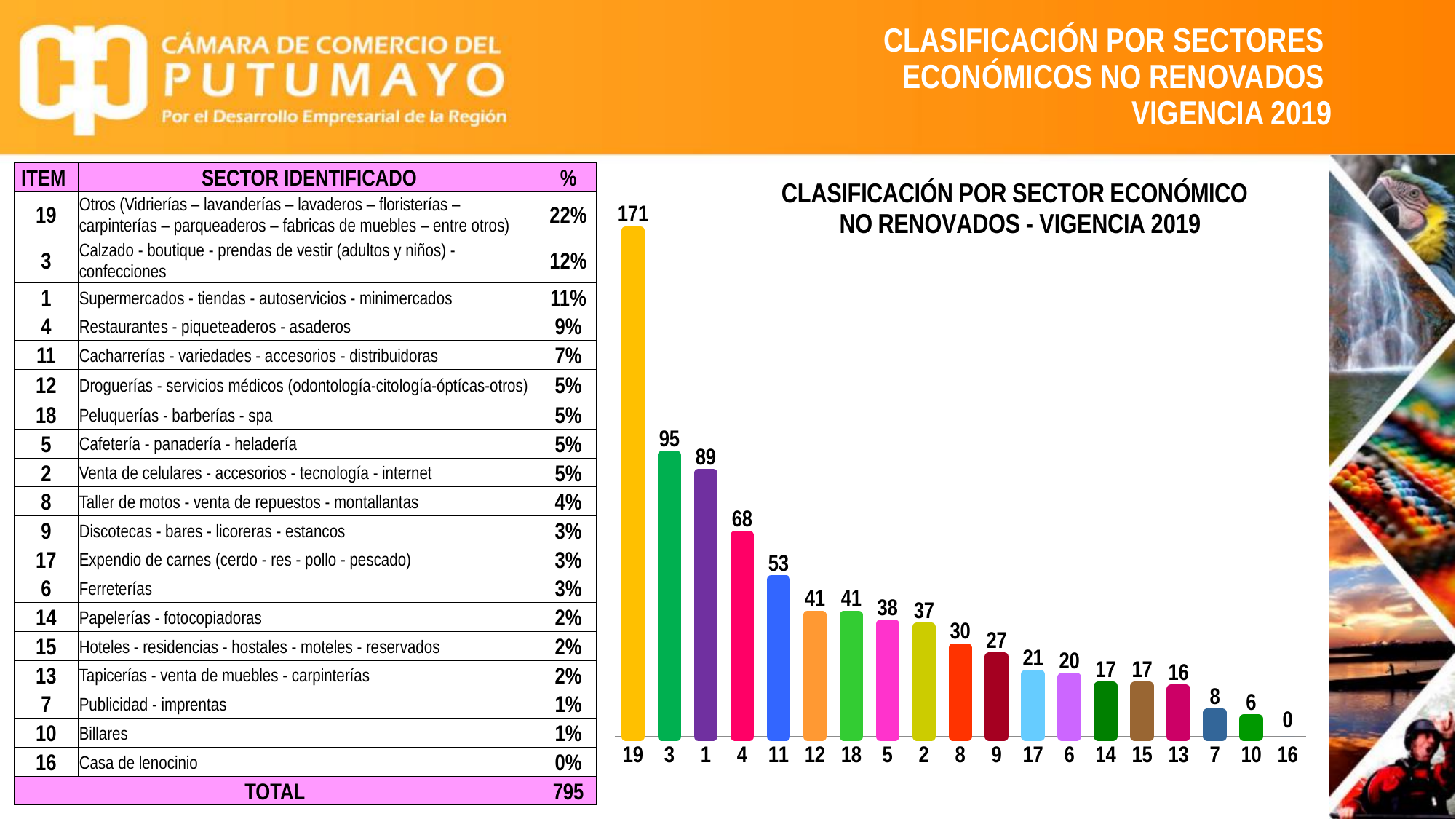
Do the values rise or fall from left to right along the x axis? fall Which item has the highest value in the chart? 19 What is the title of the chart? CLASIFICACIÓN POR SECTOR ECONÓMICO NO RENOVADOS - VIGENCIA 2019 What type of chart is shown on the slide? bar chart What is the difference between the values for item 3 and item 1? 6 What value is shown for item 9 in the chart? 27 What value is shown for item 11 in the chart? 53 How many items (bars) are plotted in the chart? 19 Which item has the lowest value in the chart? 16 What value is shown for item 19 in the chart? 171 Which has a larger value, item 8 or item 17? 8 What is the difference between the values for item 19 and item 4? 103